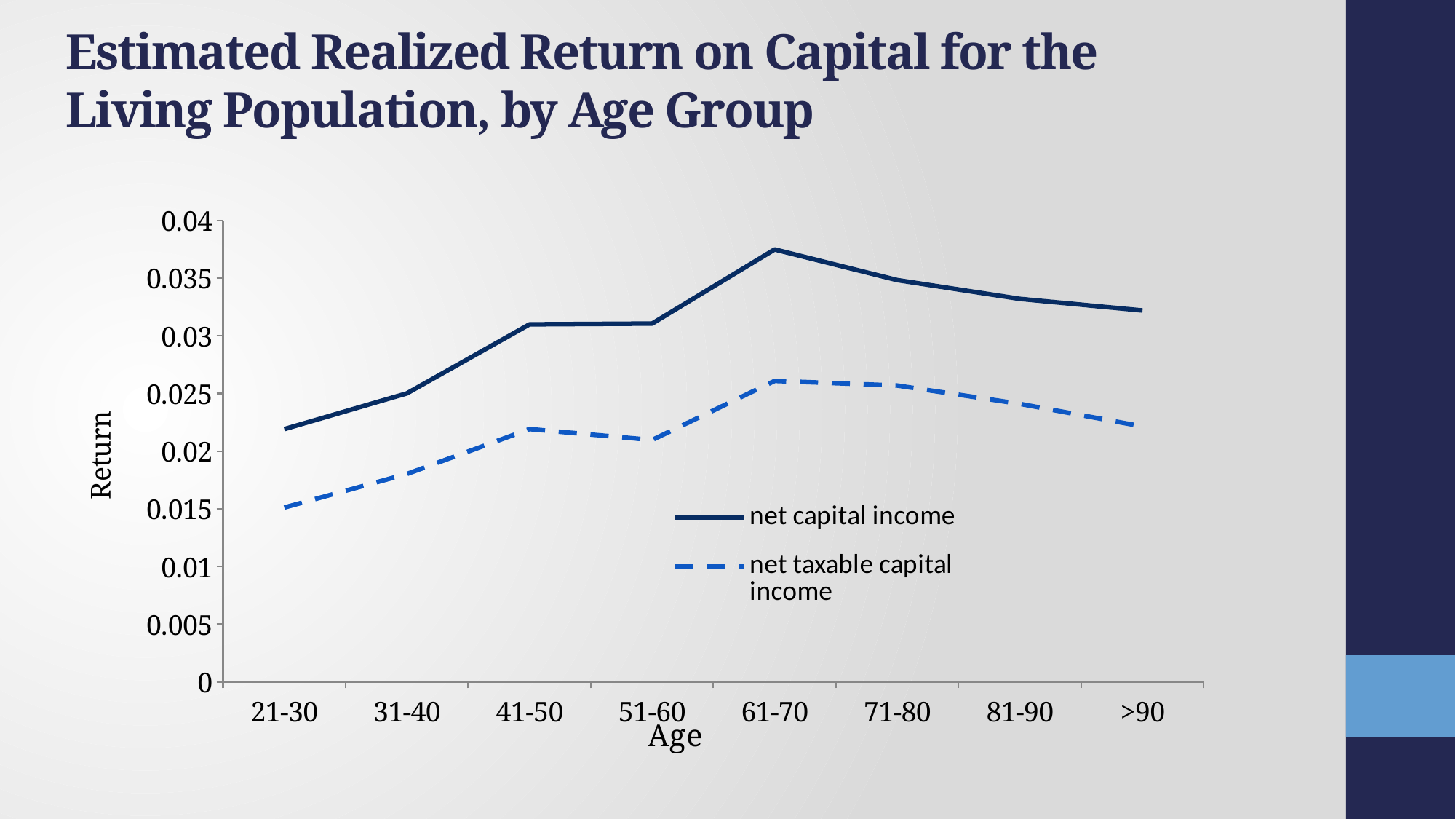
How many age groups are plotted along the x axis? 8 What is the label on the vertical axis? Return What kind of chart is shown on the slide? line chart Is the value for net capital income at age 61-70 greater or less than 0.035? greater How many series does the legend list? 2 Which age group has the highest value for net capital income? 61-70 Is the value for net capital income at age 21-30 greater or less than 0.025? less Is the value for net taxable capital income at age 21-30 greater or less than 0.02? less Does net capital income rise or fall from age 61-70 to >90? fall Which series is higher at age 41-50, net capital income or net taxable capital income? net capital income Which age group has the lowest value for net capital income? 21-30 Which age group has the lowest value for net taxable capital income? 21-30